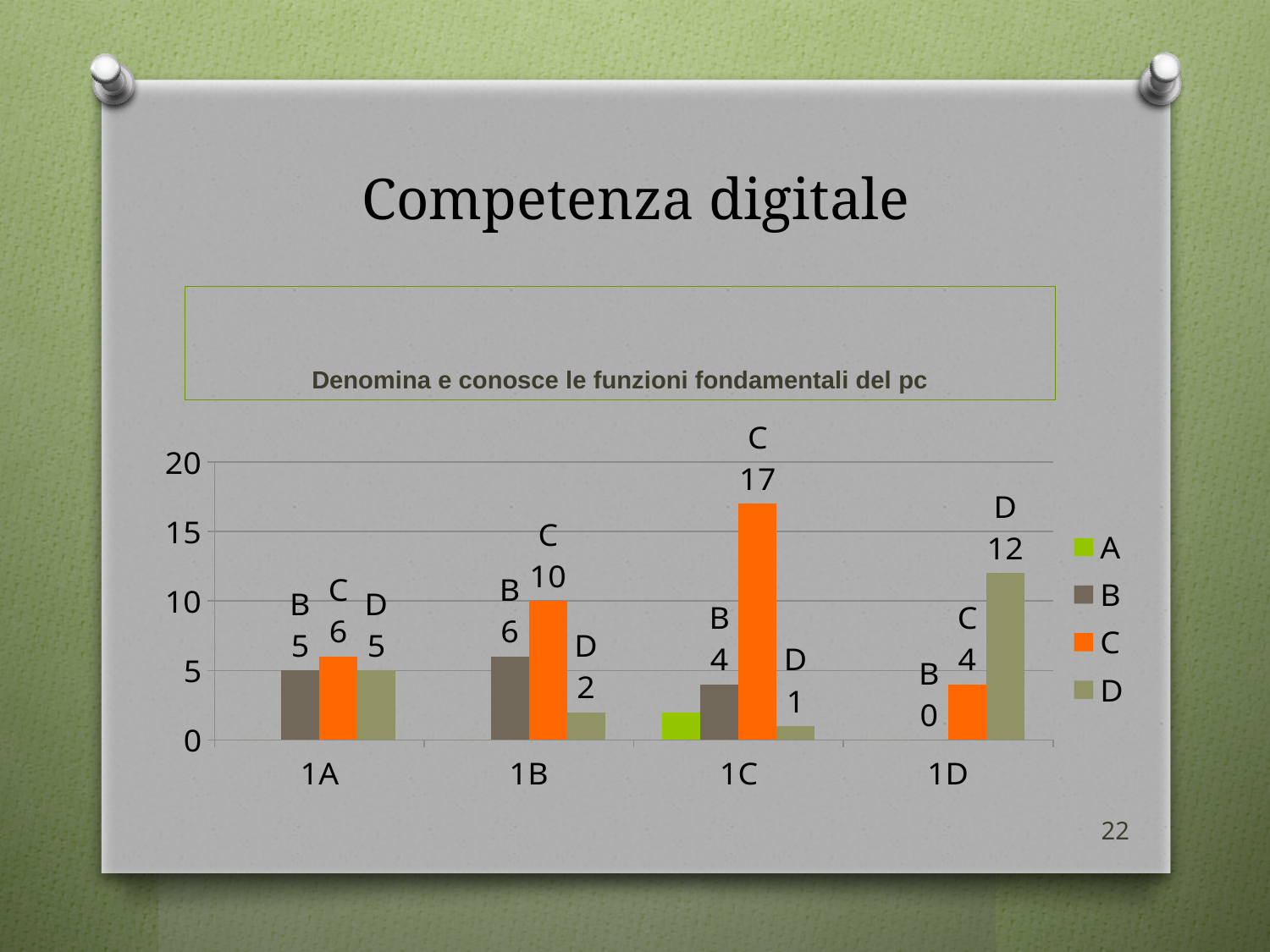
How many categories are shown on the x axis? 4 What kind of chart is shown on the slide? bar chart In which category does series C reach its highest value? 1C What is the value for series C in category 1C? 17 Is the value for series A in category 1C greater or less than 5? less In which category does series D have its lowest value? 1C What is the value for series B in category 1B? 6 What is the value for series B in category 1D? 0 What is the value for series D in category 1D? 12 How many series does the legend list? 4 What is the difference between the value of series C in 1C and the value of series C in 1B? 7 In category 1D, which is larger: the value for series C or the value for series D? D